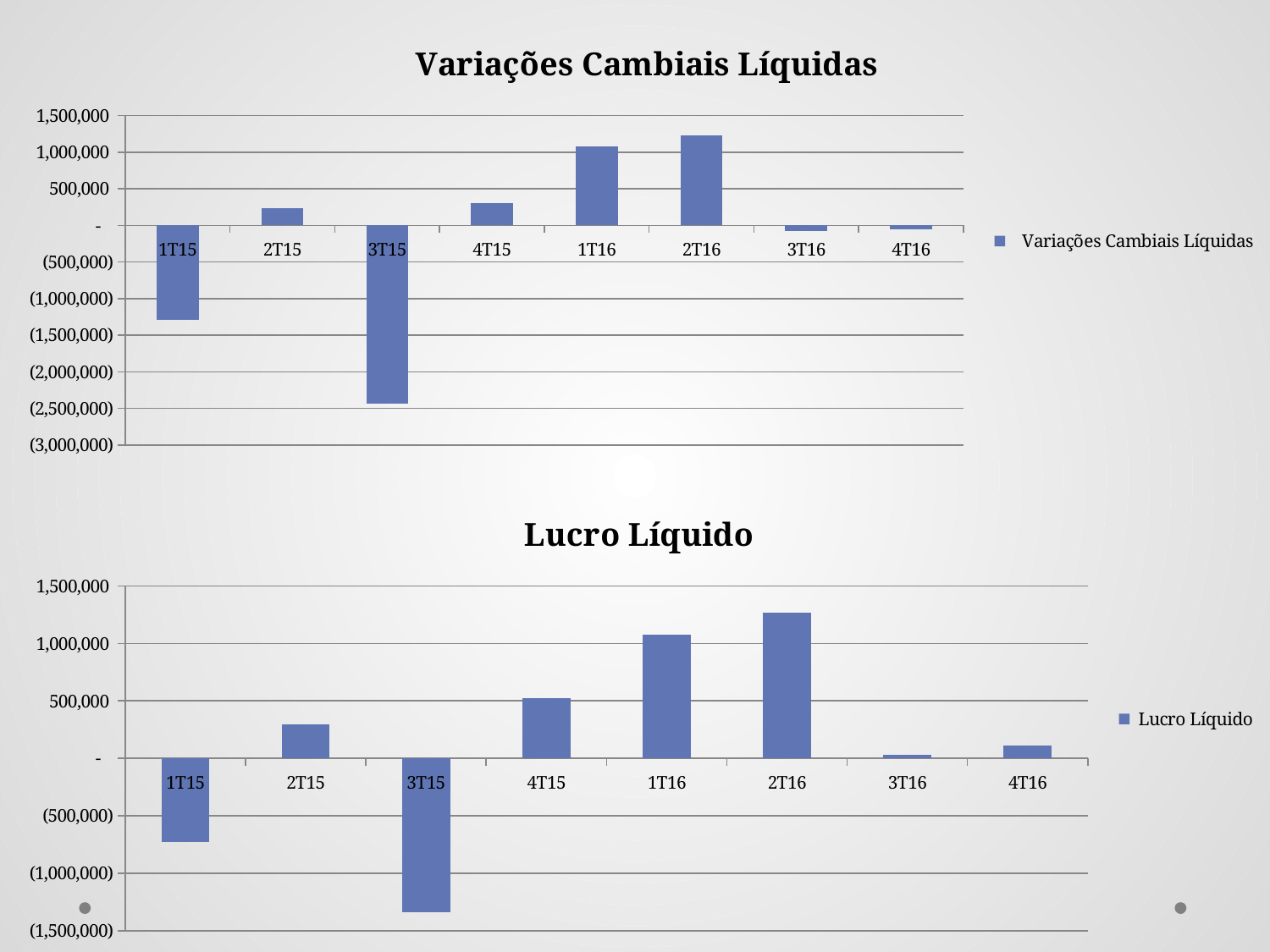
In the 'Lucro Líquido' chart, which quarter has the lowest value? 3T15 How many series does the legend of the 'Variações Cambiais Líquidas' chart list? 1 In the 'Lucro Líquido' chart, which is larger, the value for 4T15 or the value for 2T15? 4T15 In the 'Lucro Líquido' chart, is the value for 2T16 greater or less than 1,000,000? greater In the 'Variações Cambiais Líquidas' chart, which quarter has the highest value? 2T16 In the 'Lucro Líquido' chart, is the value for 1T15 greater or less than (500,000)? less In the 'Variações Cambiais Líquidas' chart, is the value for 3T15 greater or less than (2,000,000)? less How many quarters are shown on the x axis of the 'Lucro Líquido' chart? 8 What is the title of the lower chart on the slide? Lucro Líquido What kind of chart is the 'Variações Cambiais Líquidas' chart? Bar chart In the 'Lucro Líquido' chart, which quarter has the highest value? 2T16 In the 'Variações Cambiais Líquidas' chart, which quarter has the lowest value? 3T15